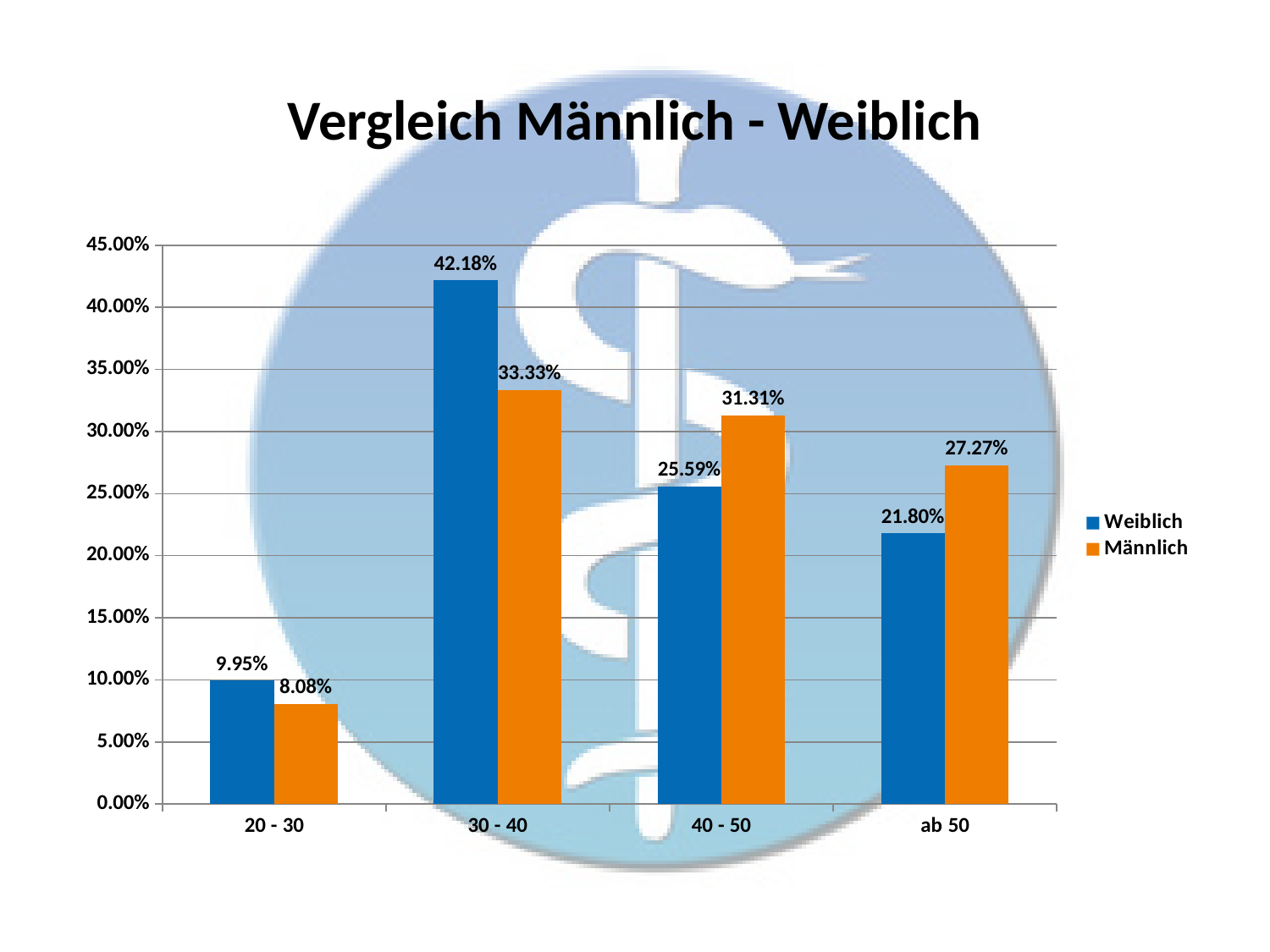
Which age group has the highest Weiblich value? 30 - 40 What is the title of the chart? Vergleich Männlich - Weiblich What is the difference between the Weiblich and Männlich values for the 30 - 40 age group? 8.85% How many series does the legend list? 2 What is the Männlich value for the ab 50 age group? 27.27% What is the Männlich value for the 20 - 30 age group? 8.08% Which age group has the lowest Männlich value? 20 - 30 How many age groups are shown on the x axis? 4 What is the Weiblich value for the 30 - 40 age group? 42.18% For the 40 - 50 age group, which series has the larger value, Weiblich or Männlich? Männlich What kind of chart is shown on the slide? Bar chart Which colour represents the Männlich series? Orange